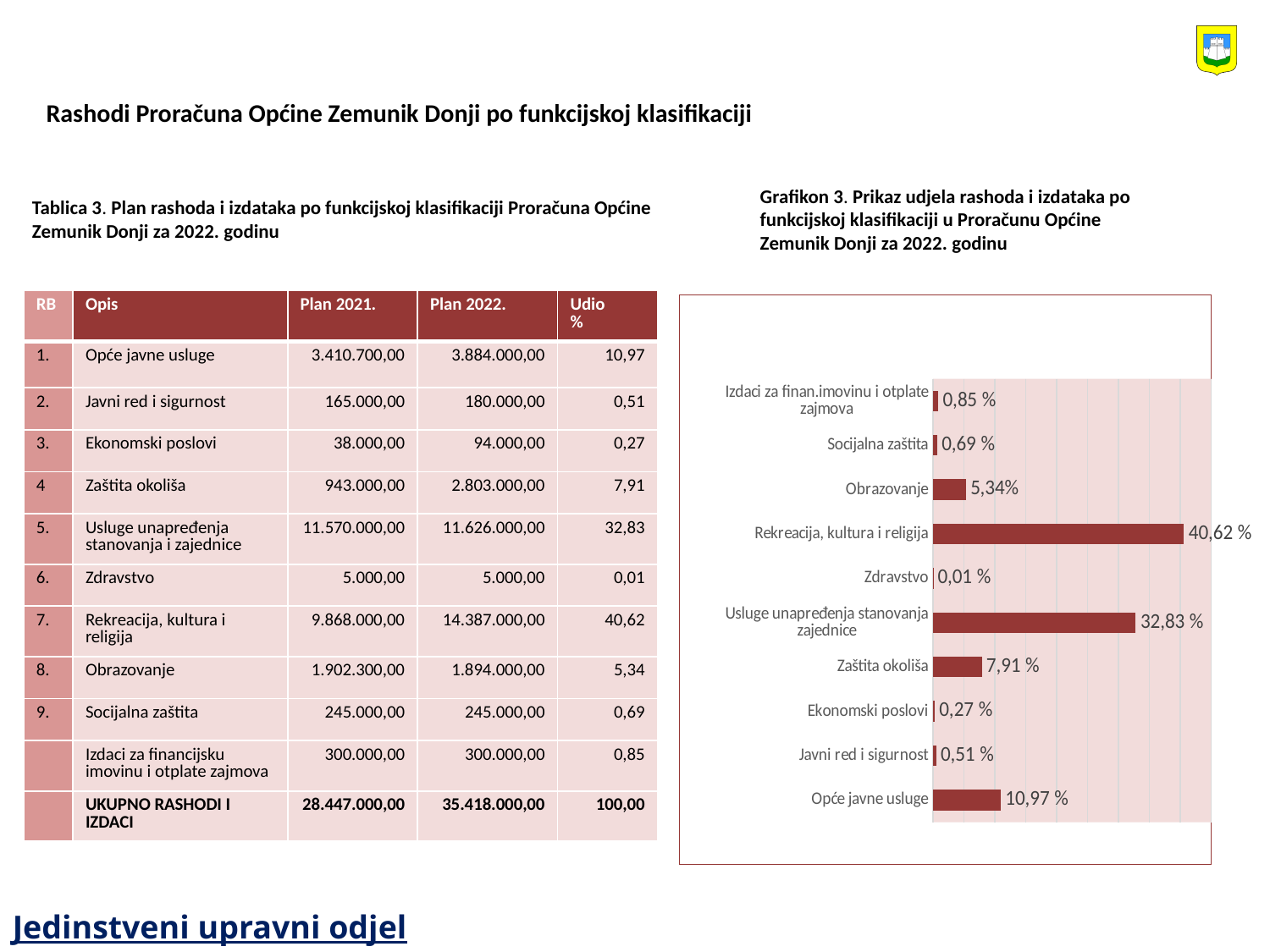
What is the value shown for Zaštita okoliša? 7,91 % What is the value shown for Opće javne usluge? 10,97 % Which category has the highest value in the chart? Rekreacija, kultura i religija Which is larger, the value for Obrazovanje or the value for Zaštita okoliša? Zaštita okoliša What is the value shown for Usluge unapređenja stanovanja zajednice? 32,83 % What is the difference between the values for Rekreacija, kultura i religija and Usluge unapređenja stanovanja zajednice? 7,79 % What is the value shown for Zdravstvo? 0,01 % What kind of chart is shown on the slide? bar chart What is the value shown for Rekreacija, kultura i religija? 40,62 % Which category has the lowest value in the chart? Zdravstvo How many categories are shown in the chart? 10 What is the title of the chart? Grafikon 3. Prikaz udjela rashoda i izdataka po funkcijskoj klasifikaciji u Proračunu Općine Zemunik Donji za 2022. godinu